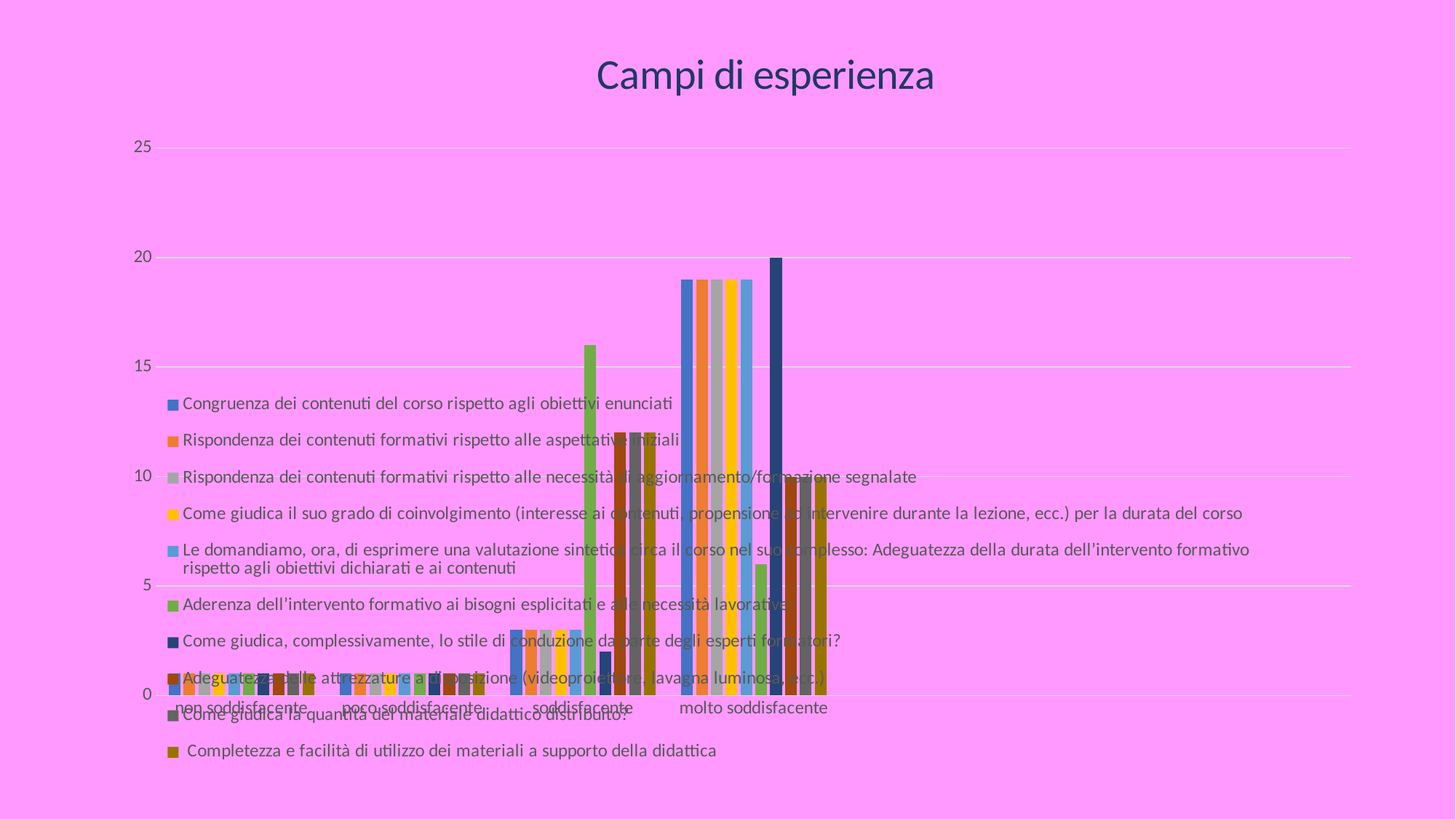
Which series has the highest bar in the 'soddisfacente' category? Aderenza dell'intervento formativo ai bisogni esplicitati e alle necessità lavorative For 'Congruenza dei contenuti del corso rispetto agli obiettivi enunciati', do the values rise or fall from 'non soddisfacente' to 'molto soddisfacente'? rise How many series does the legend list? 10 Is the value for 'Aderenza dell'intervento formativo ai bisogni esplicitati e alle necessità lavorative' in 'molto soddisfacente' greater or less than 10? less Which series has the highest bar in the 'molto soddisfacente' category? Come giudica, complessivamente, lo stile di conduzione da parte degli esperti formatori? Is the value for 'Aderenza dell'intervento formativo ai bisogni esplicitati e alle necessità lavorative' in 'soddisfacente' greater or less than 15? greater What is the value for 'Come giudica, complessivamente, lo stile di conduzione da parte degli esperti formatori?' in the 'molto soddisfacente' category? 20 What is the title of the chart? Campi di esperienza How many categories are shown on the x axis? 4 Is the value for 'Congruenza dei contenuti del corso rispetto agli obiettivi enunciati' in 'soddisfacente' greater or less than 5? less For 'Aderenza dell'intervento formativo ai bisogni esplicitati e alle necessità lavorative', which category has the larger value: 'soddisfacente' or 'molto soddisfacente'? soddisfacente What kind of chart is shown on the slide? bar chart